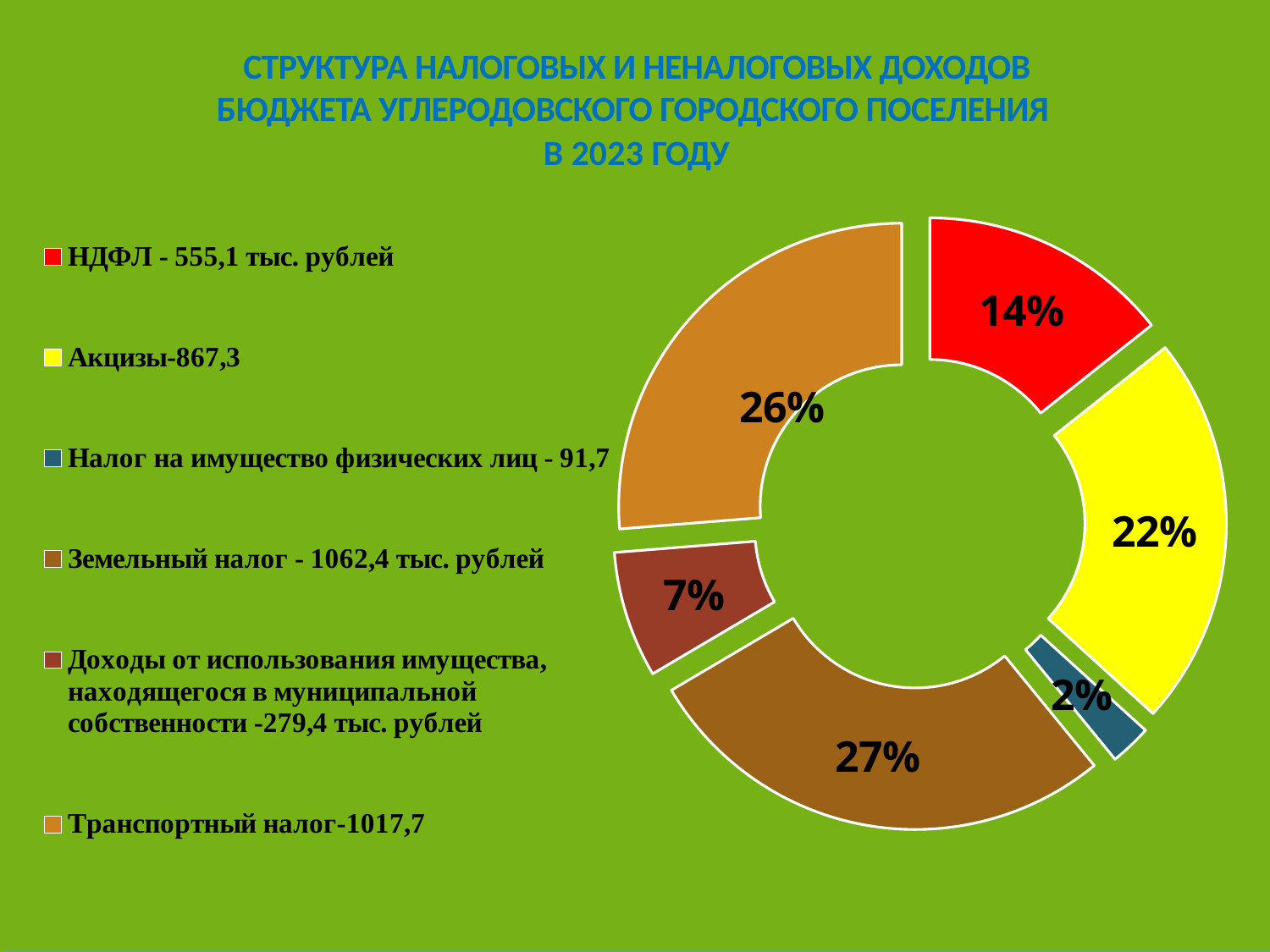
What share of the doughnut chart does НДФЛ represent? 14% What kind of chart is shown on the slide? Doughnut (pie) chart How many slices does the chart have? 6 What percentage is shown for the Акцизы slice? 22% What is the difference in percentage points between the Земельный налог slice and the Транспортный налог slice? 1 percentage point Which category has the smallest share of the chart? Налог на имущество физических лиц Which slice is larger: Акцизы or НДФЛ? Акцизы What colour is the Акцизы slice? Yellow Which year does the chart title refer to? 2023 What percentage is shown for the Транспортный налог slice? 26% Which category has the largest share of the chart? Земельный налог What amount in thousand rubles does the legend give for Земельный налог? 1062,4 тыс. рублей